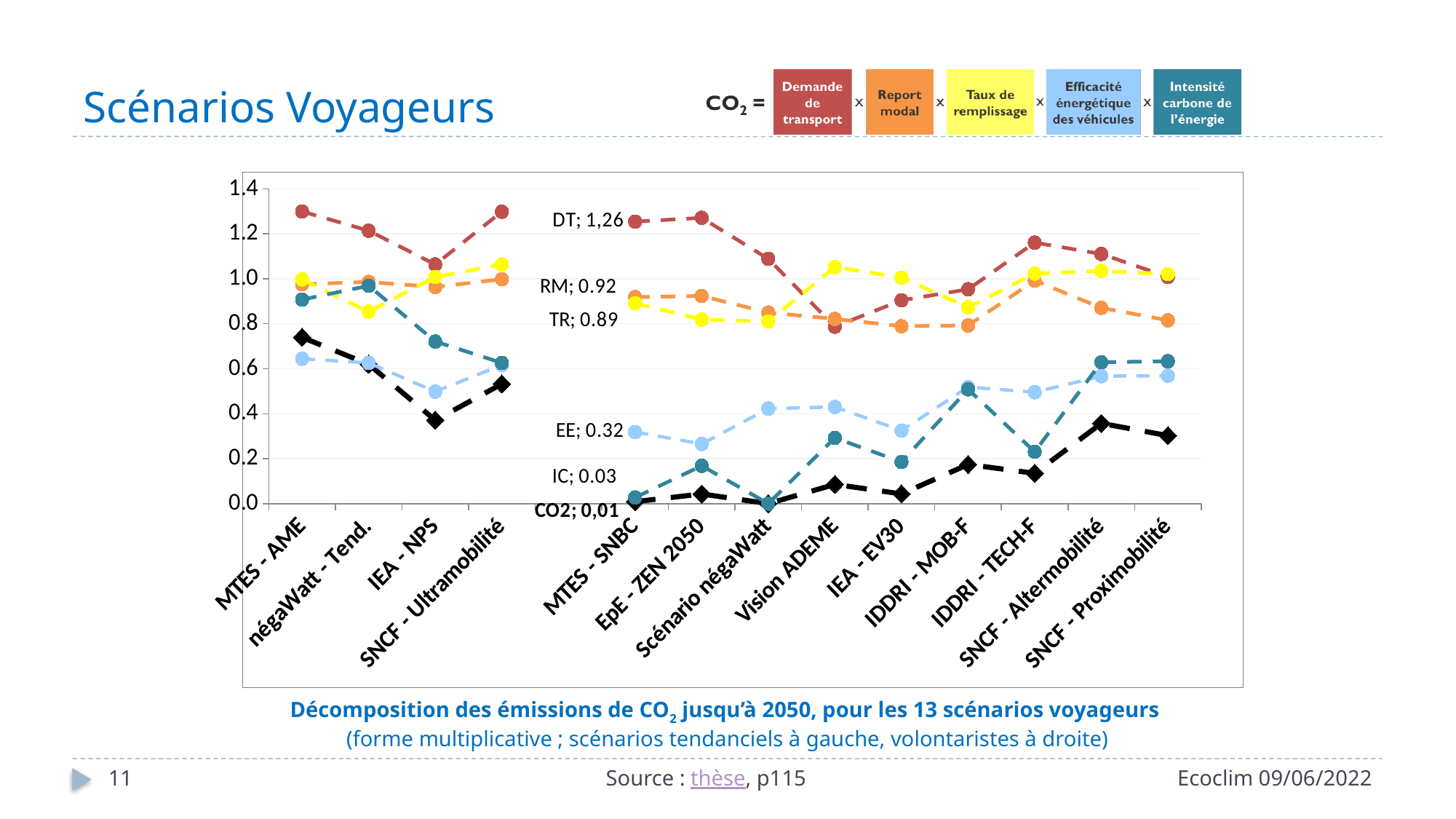
What is the labelled value of the EE series at MTES - SNBC? 0.32 What is the labelled value of the RM series at MTES - SNBC? 0.92 What kind of chart is shown on the slide? line chart Which scenario has the highest CO2 (black) value? MTES - AME Is the DT value for MTES - AME greater or less than 1.2? greater What is the labelled value of the DT series at MTES - SNBC? 1,26 What is the labelled value of the TR series at MTES - SNBC? 0.89 How many scenarios are plotted along the x axis of the chart? 13 What is the labelled value of the CO2 series at MTES - SNBC? 0,01 How many factors are multiplied together in the CO2 formula shown at the top of the slide? 5 What is the difference between the labelled DT value (1,26) and the labelled RM value (0.92) at MTES - SNBC? 0.34 At MTES - AME, which is larger: the DT value or the CO2 value? DT